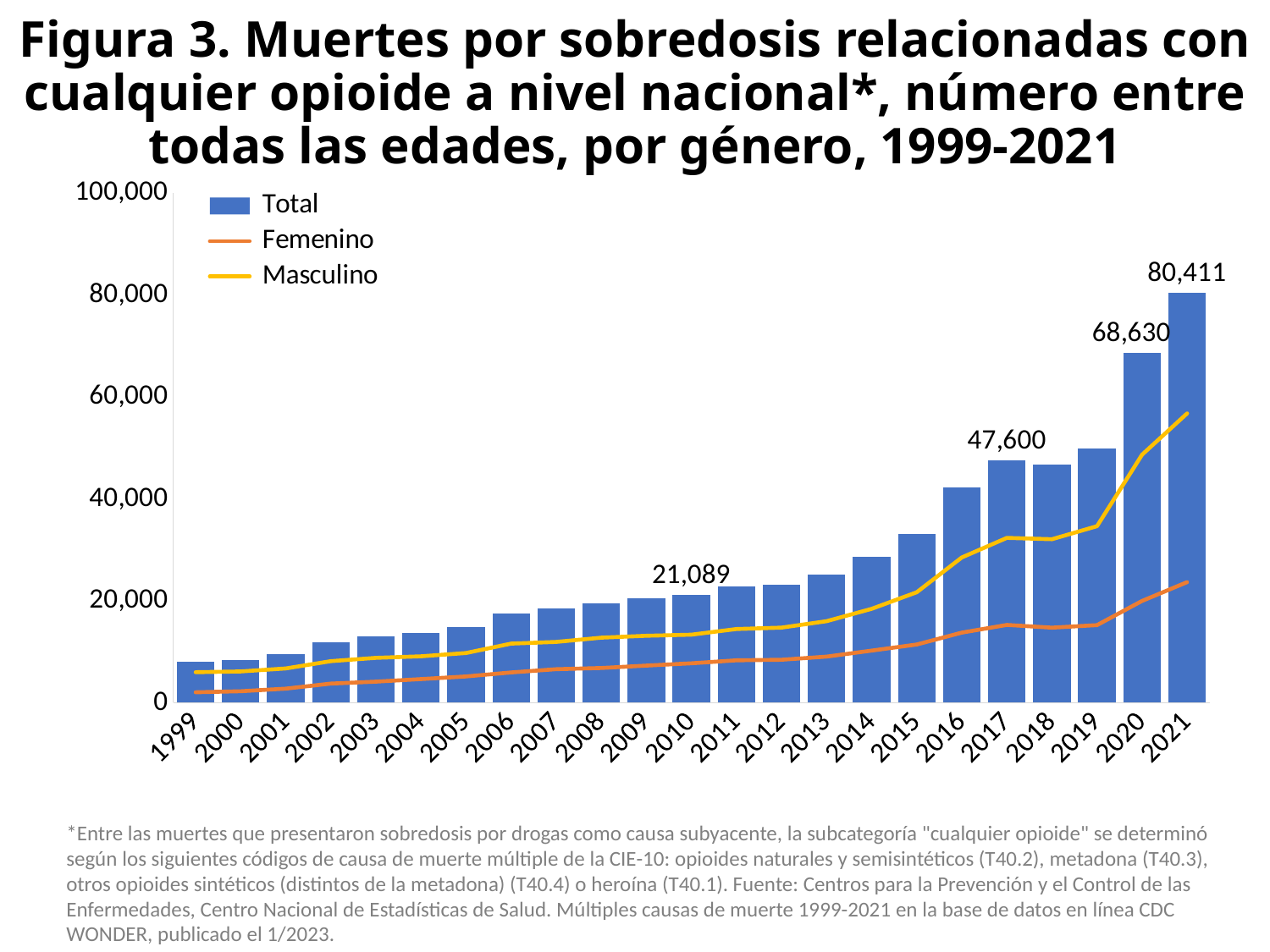
Which year has the highest Total? 2021 Is the Total value for 2015 greater or less than 40,000? less What is the Total number of opioid-related overdose deaths shown for 2021? 80,411 By how much did the Total increase from 2020 to 2021? 11,781 What is the difference between the Total for 2020 and the Total for 2017? 21,030 What is the Total value labeled for 2010? 21,089 What is the Total value labeled for 2017? 47,600 In 2021, which series is higher, Masculino or Femenino? Masculino What is the Total value labeled for 2020? 68,630 Does the Total generally rise or fall from 1999 to 2021? rise How many series does the legend list? 3 How many years are shown on the x axis? 23